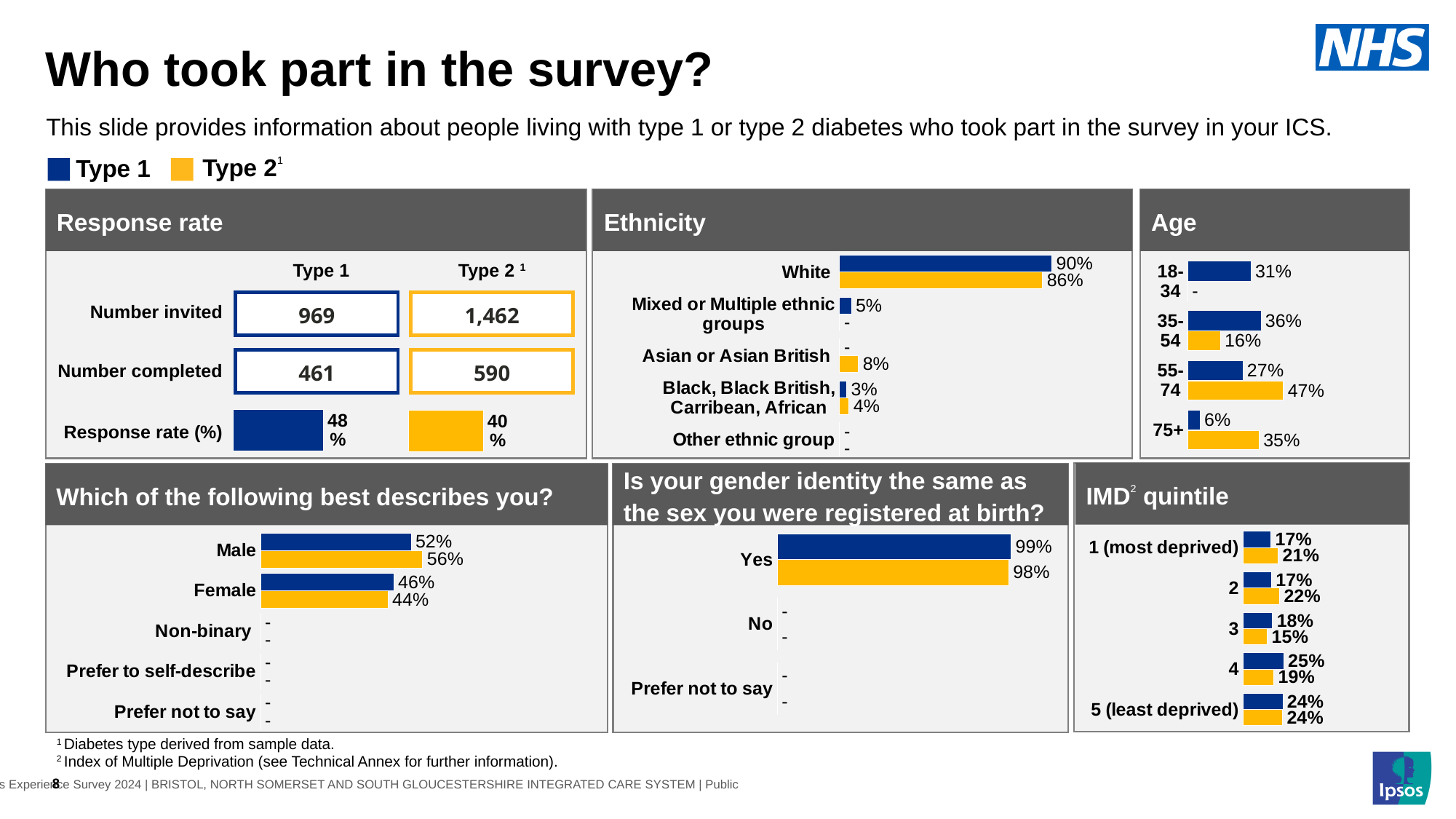
In the Ethnicity chart, what is the Type 2 value for White? 86% In the Response rate chart, what is the difference between the number completed for Type 2 and Type 1? 129 In the Response rate chart, what is the number invited for Type 2? 1,462 In the Age chart, what is the Type 2 value for 55-74? 47% In the 'Is your gender identity the same as the sex you were registered at birth?' chart, what is the Type 1 value for Yes? 99% In the Age chart, which age group has the highest Type 1 value? 35-54 In the Response rate chart, what is the response rate for Type 1? 48% In the Age chart, what is the difference between the Type 2 and Type 1 values for 75+? 29% In the IMD quintile chart, which quintile has the highest Type 1 value? 4 In the 'Which of the following best describes you?' chart, is the Type 1 or Type 2 value larger for Male? Type 2 How many series does the legend at the top of the slide list? 2 In the Ethnicity chart, which ethnic group has the highest Type 1 value? White